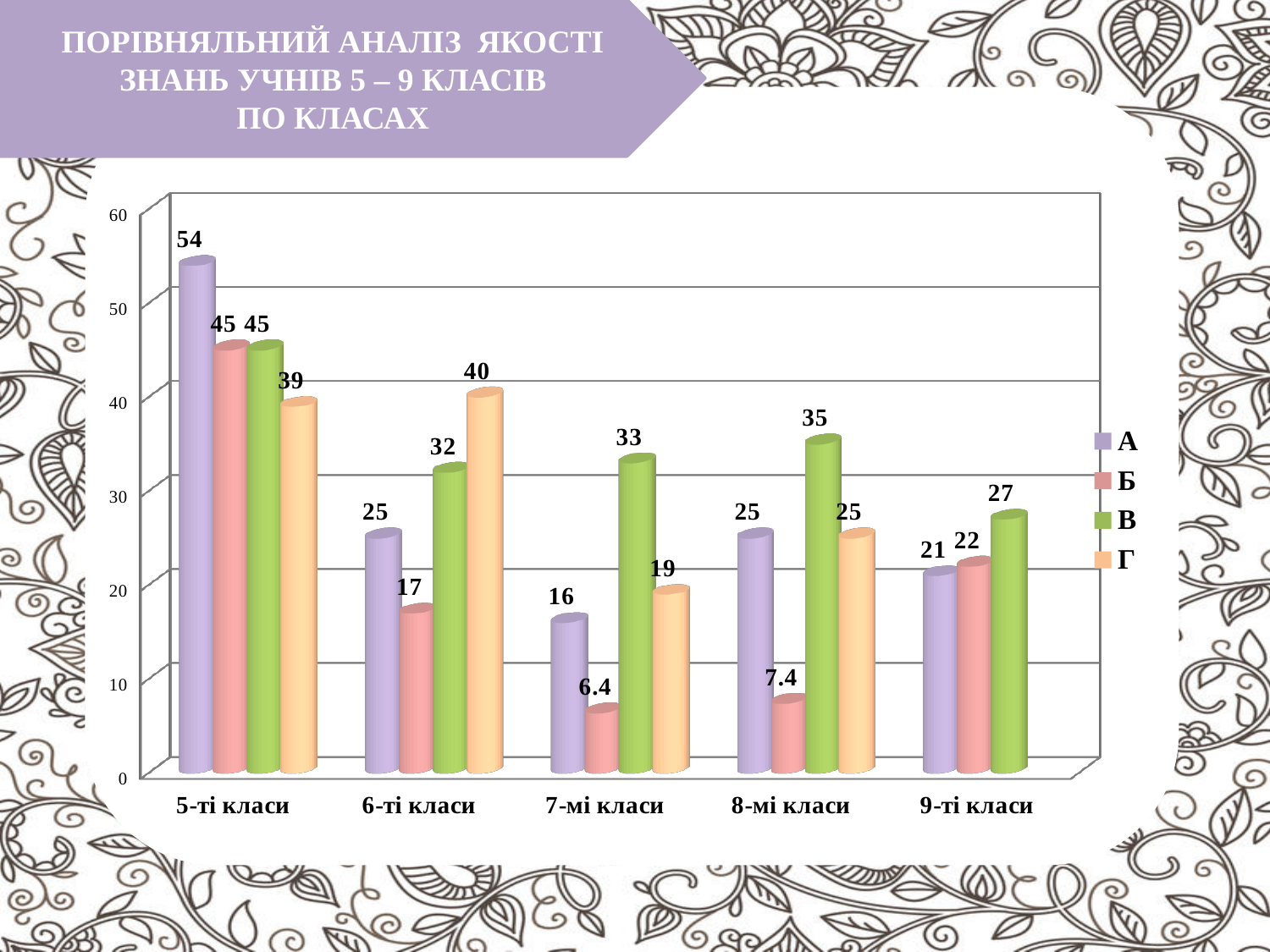
Which is larger in the 9-ті класи group: series А or series В? В What kind of chart is shown on the slide? bar chart How do the values for series А change from 5-ті класи to 7-мі класи? They fall What is the value for series Б in the 7-мі класи group? 6.4 What is the value for series А in the 5-ті класи group? 54 What colour represents series В in the legend? green What is the value for series Г in the 6-ті класи group? 40 How many series does the legend list? 4 How many class groups are shown on the x axis? 5 Which series has the highest value in the 8-мі класи group? В What is the difference between series В and series Б in the 7-мі класи group? 26.6 Which series has the lowest value in the 6-ті класи group? Б